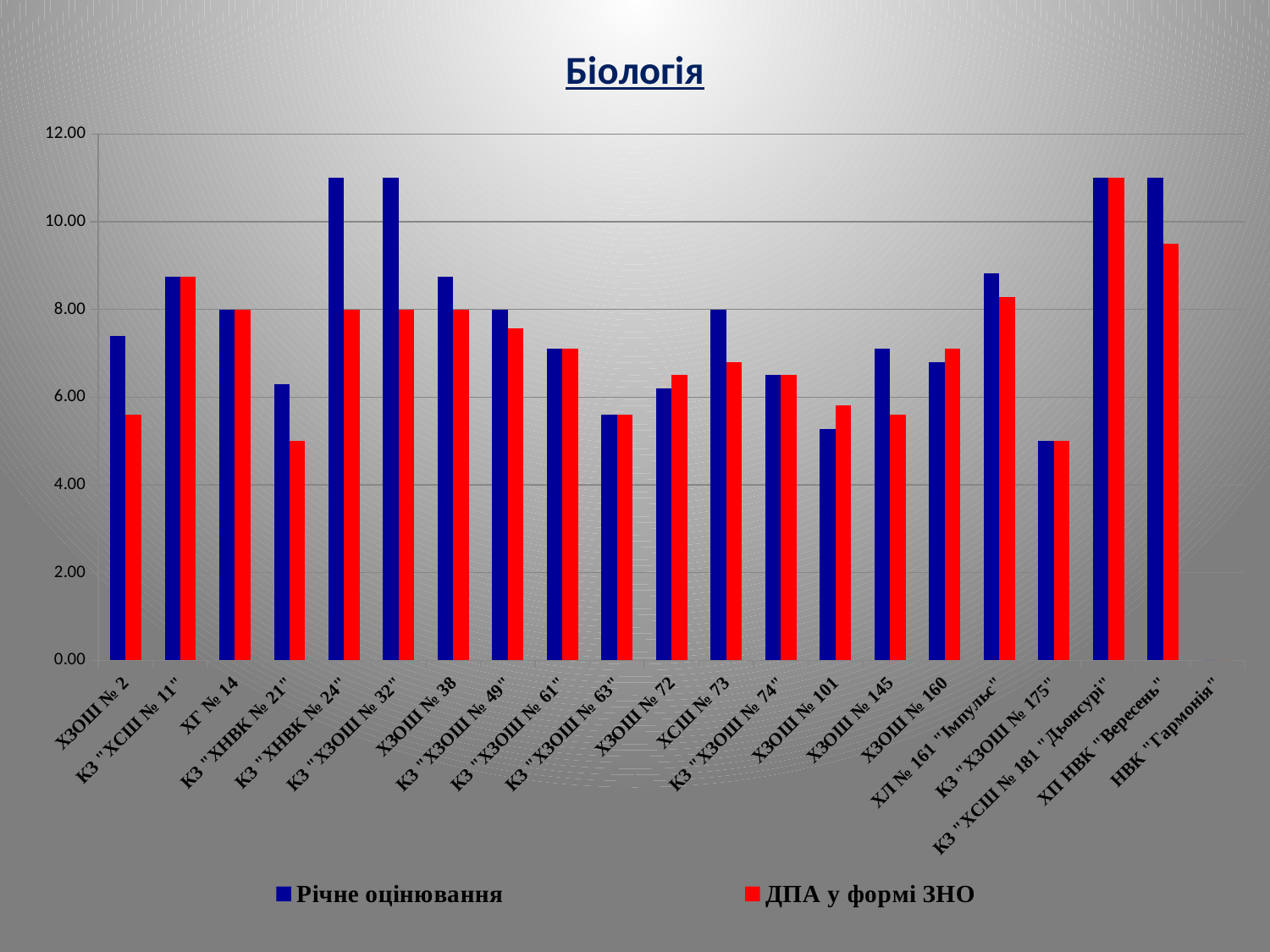
Which category has the highest ДПА у формі ЗНО value? КЗ "ХСШ № 181 "Дьонсурі" Is the ДПА у формі ЗНО value for ХЗОШ № 2 greater or less than 6.00? less What is the title of the chart? Біологія Is the ДПА у формі ЗНО value for ХП НВК "Вересень" greater or less than 8.00? greater Is the Річне оцінювання value for КЗ "ХНВК № 24" greater or less than 10.00? greater How many series does the legend list? 2 For ХЛ № 161 "Імпульс", which is larger: Річне оцінювання or ДПА у формі ЗНО? Річне оцінювання For ХЗОШ № 101, which is larger: Річне оцінювання or ДПА у формі ЗНО? ДПА у формі ЗНО Which series is shown in blue? Річне оцінювання How many categories are shown on the x axis? 21 What kind of chart is shown on the slide? bar chart